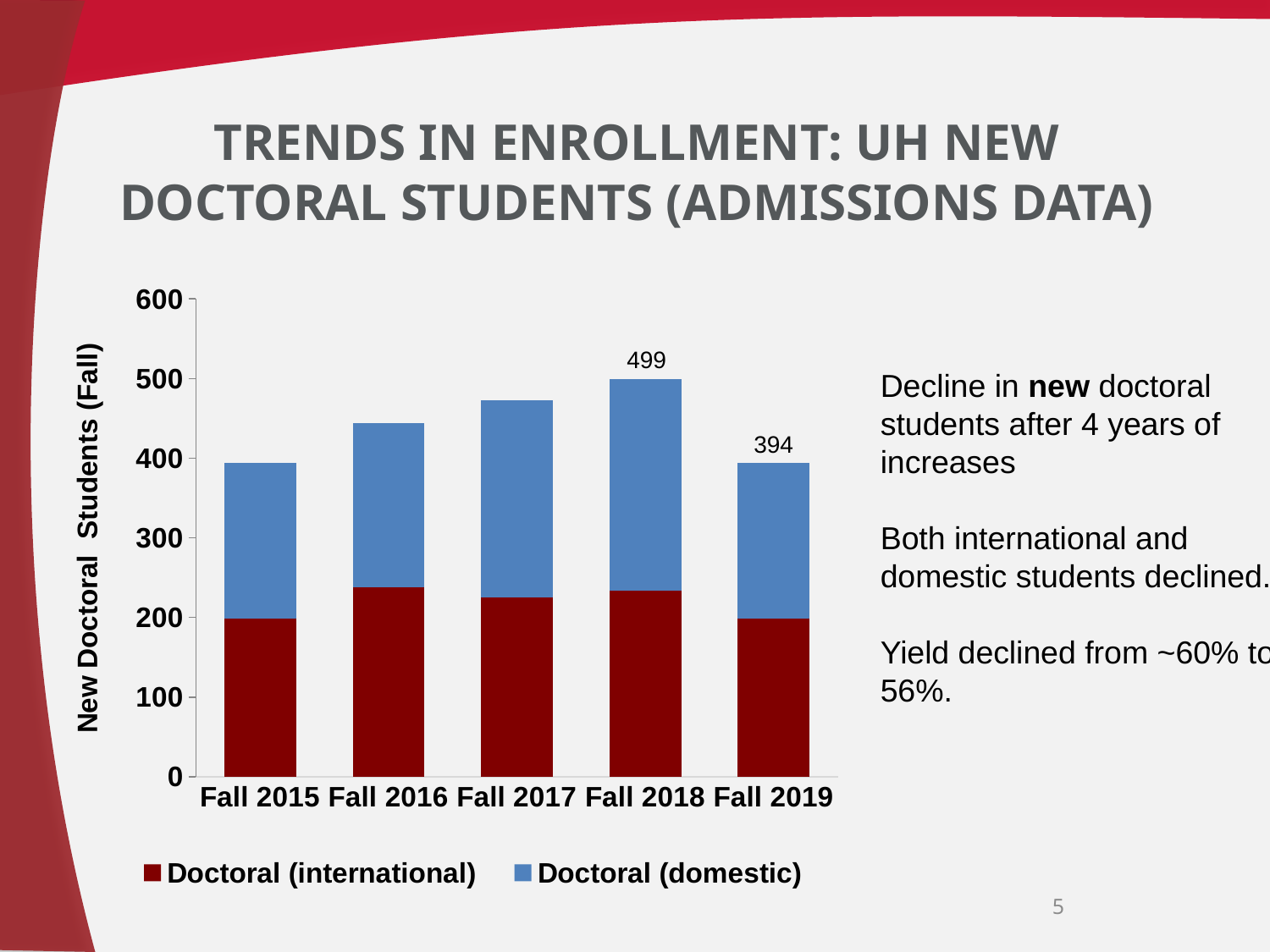
What is the total number of new doctoral students for Fall 2018? 499 What kind of chart is shown on the slide? bar chart Do the total bar heights rise or fall from Fall 2015 to Fall 2018? rise What is the total number of new doctoral students for Fall 2019? 394 By how much did the total number of new doctoral students fall from Fall 2018 to Fall 2019? 105 Is the total number of new doctoral students for Fall 2016 greater or less than 400? greater What are the two series named in the chart's legend? Doctoral (international) and Doctoral (domestic) How many fall terms are shown on the x axis of the chart? 5 Is the Doctoral (international) value for Fall 2016 greater or less than 200? greater How many series does the chart's legend list? 2 Which has the larger total of new doctoral students, Fall 2018 or Fall 2019? Fall 2018 Which fall term has the highest total of new doctoral students? Fall 2018